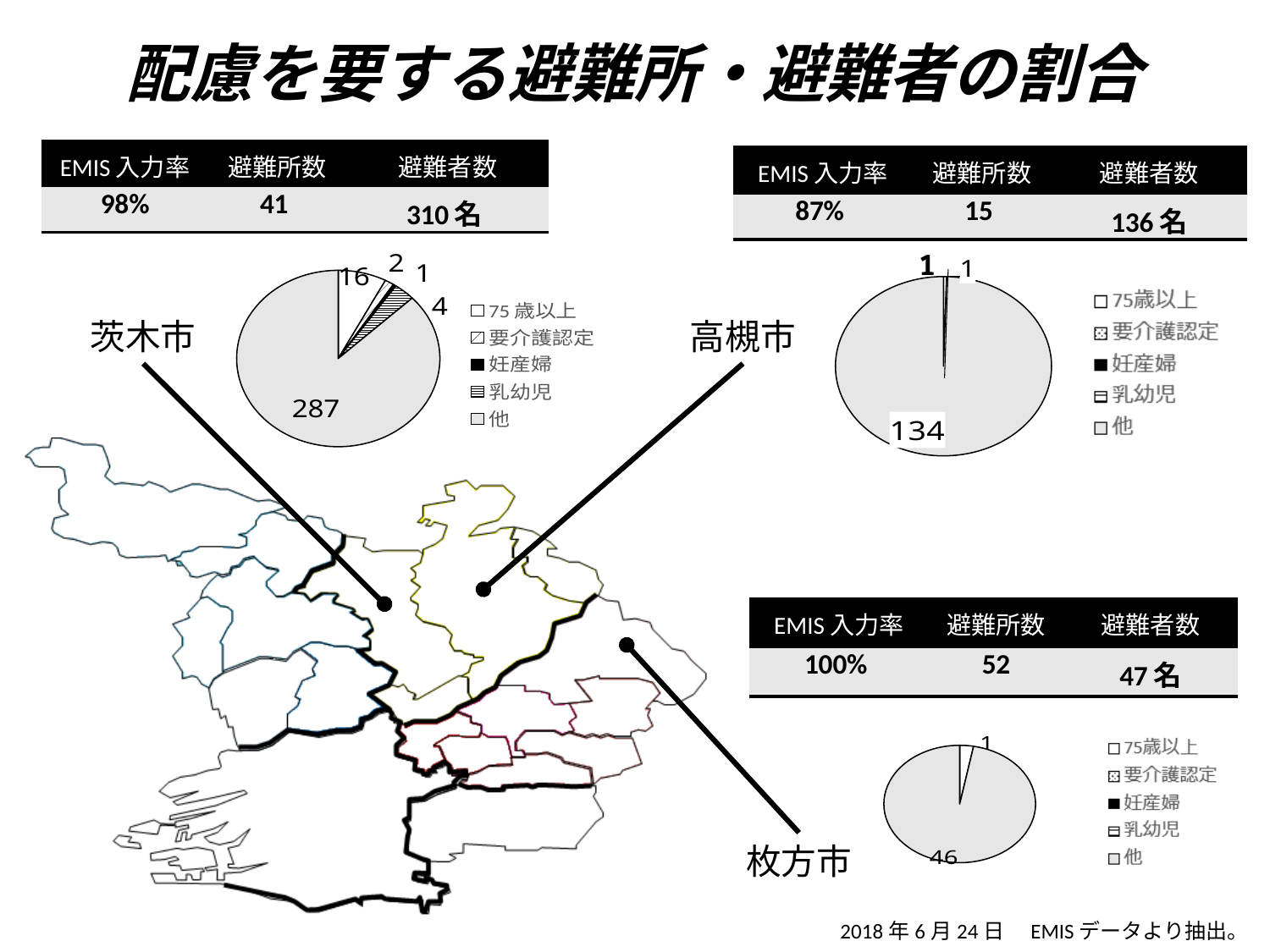
In the 茨木市 pie chart, what is the value of the 75歳以上 slice? 16 In the 茨木市 pie chart, what is the value of the largest slice? 287 In the 高槻市 pie chart, what is the value of the largest slice? 134 What kind of chart is used for 茨木市? pie chart What is the sum of all labelled slice values in the 茨木市 pie chart? 310 How many slices are labelled in the 茨木市 pie chart? 5 What is the first legend entry of the 枚方市 pie chart? 75歳以上 In the 茨木市 pie chart, what is the difference between the 287 slice and the 16 slice? 271 In the 茨木市 pie chart, what is the value of the 他 slice? 287 How many entries does the legend of the 茨木市 pie chart list? 5 In the 枚方市 pie chart, what is the value of the smallest slice? 1 In the 茨木市 pie chart, which is larger: the slice labelled 16 or the slice labelled 4? 16